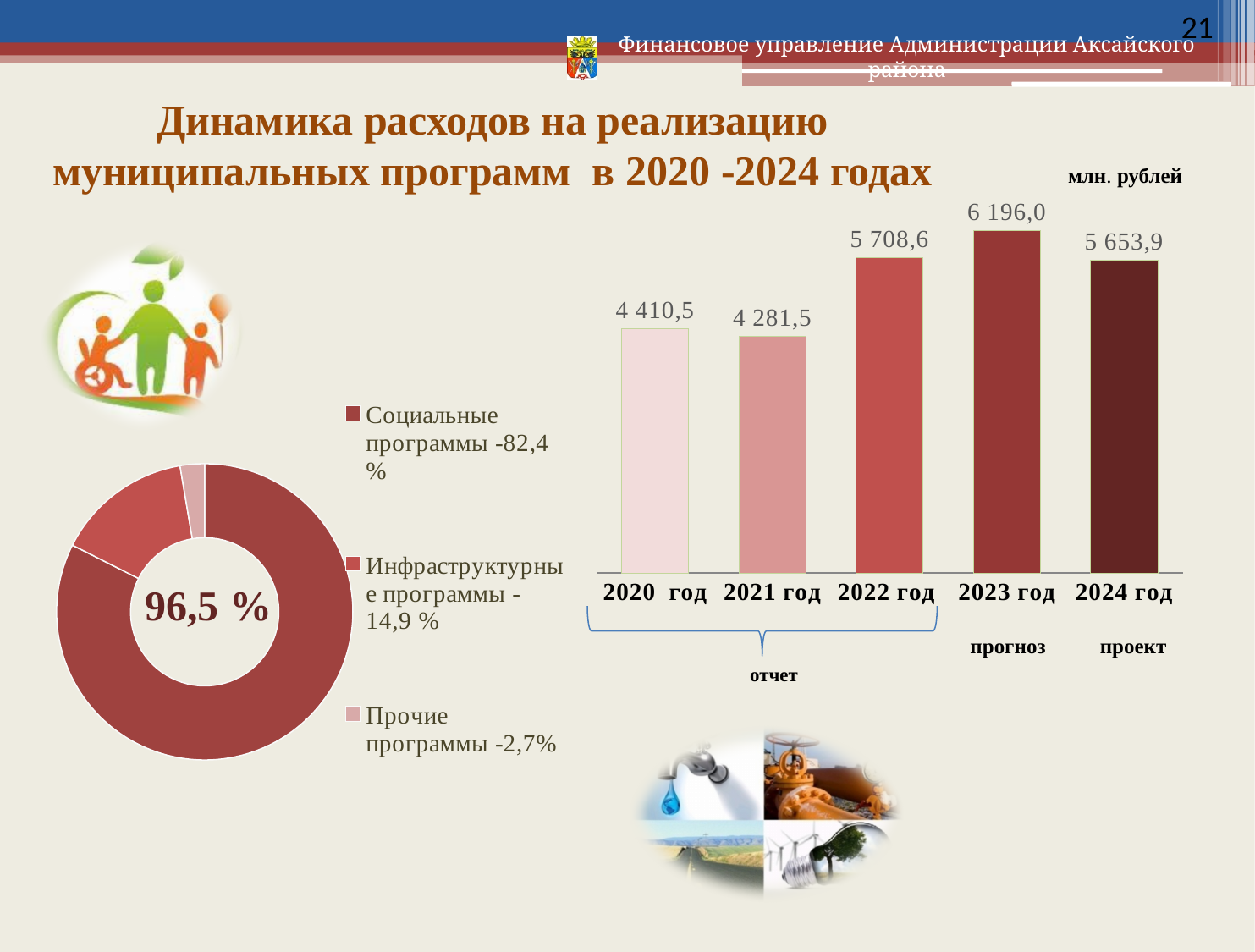
In the bar chart, what is the value for 2022 год? 5 708,6 How many bars are in the bar chart? 5 In the bar chart, what is the difference between the values for 2023 год and 2024 год? 542,1 In the bar chart, which year has the highest value? 2023 год How many entries does the legend of the doughnut chart list? 3 In the bar chart, which year has the lowest value? 2021 год In the doughnut chart, what share is shown for Социальные программы? 82,4 % In the bar chart, which is larger: the value for 2020 год or 2021 год? 2020 год In the bar chart, what is the value for 2020 год? 4 410,5 In the bar chart, what is the difference between the values for 2022 год and 2021 год? 1 427,1 In the bar chart, do the values rise or fall from 2021 год to 2023 год? rise What type of chart is the chart on the right side of the slide? bar chart